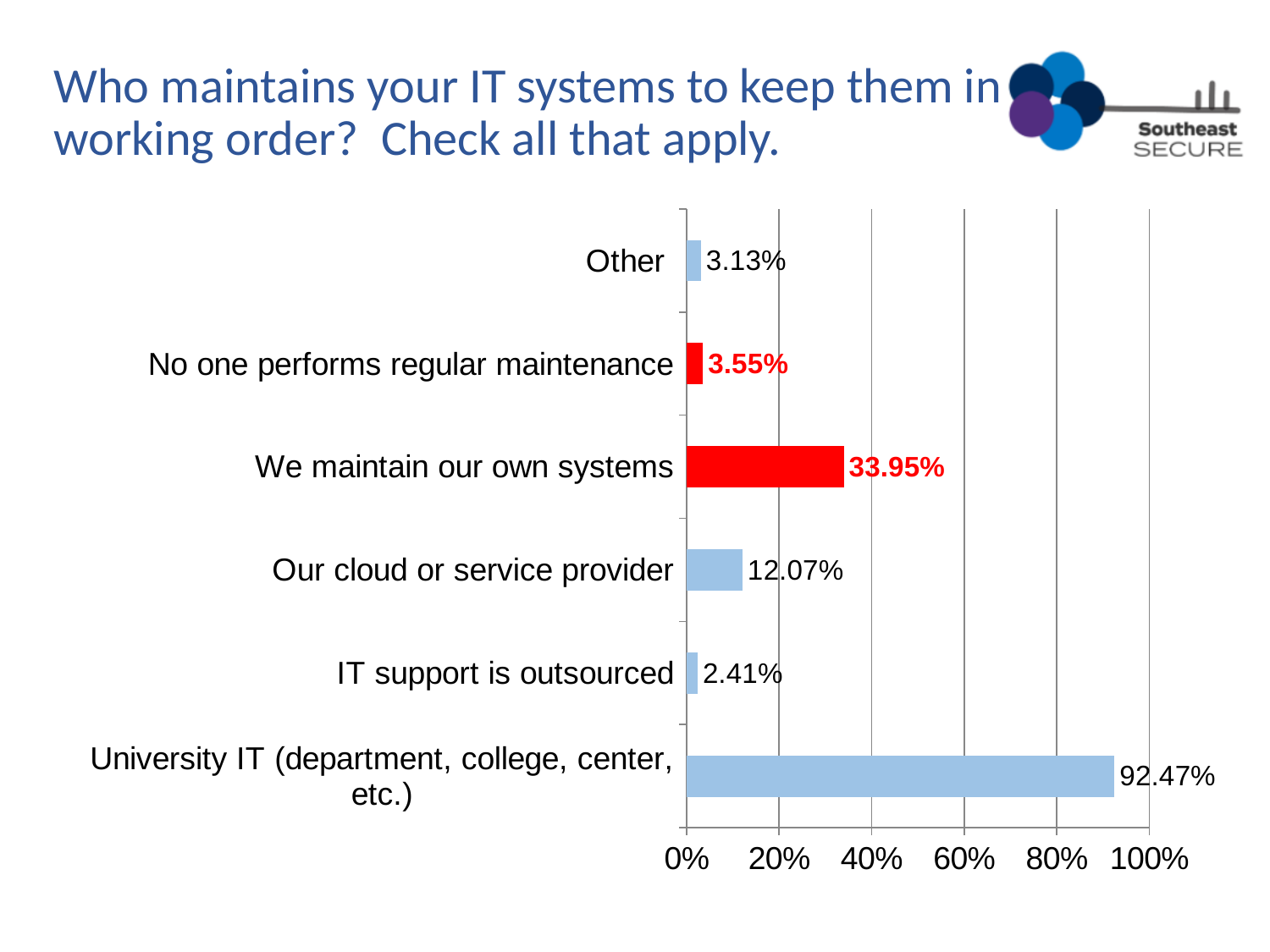
How many categories are shown in the chart? 6 Which two bars are highlighted in red? No one performs regular maintenance and We maintain our own systems Which category has the highest value? University IT (department, college, center, etc.) Which is larger: the value for "Other" or the value for "No one performs regular maintenance"? No one performs regular maintenance What kind of chart is shown on the slide? Bar chart What is the difference between the values for "We maintain our own systems" and "Our cloud or service provider"? 21.88% What percentage of respondents said University IT (department, college, center, etc.) maintains their IT systems? 92.47% What is the value for "Our cloud or service provider"? 12.07% Is the value for "We maintain our own systems" greater or less than 40%? less Which category has the lowest value? IT support is outsourced What is the value for "No one performs regular maintenance"? 3.55% What is the value for "We maintain our own systems"? 33.95%